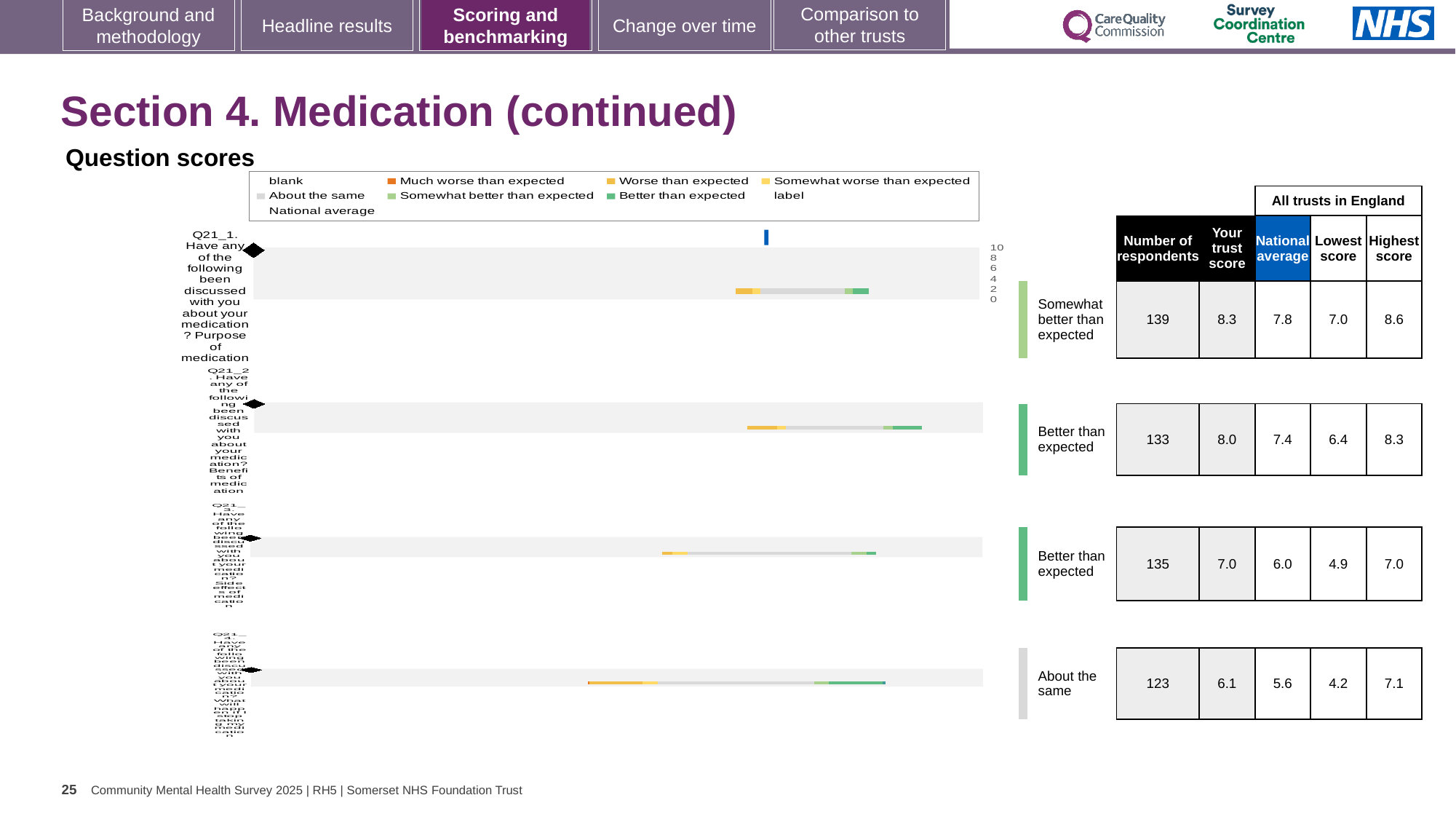
For Q21_2, which is larger: the trust score or the national average? The trust score How many respondents answered Q21_2 (Benefits of medication)? 133 What is the national average for the third question chart (Q21_3)? 6.0 What is the highest score across all trusts in England for the fourth question chart (Q21_4)? 7.1 For Q21_4, what is the difference between the highest score and the lowest score across all trusts in England? 2.9 What is the 'Your trust score' for Q21_1 (Purpose of medication)? 8.3 What benchmark category is shown next to the Q21_1 chart? Somewhat better than expected How many question charts are shown on this slide? 4 What is the lowest score across all trusts in England for the third question chart (Q21_3)? 4.9 For Q21_1, what is the difference between the trust score and the national average? 0.5 Which question has the lowest 'Your trust score' on this slide? Q21_4 Which question has the highest 'Your trust score' on this slide? Q21_1